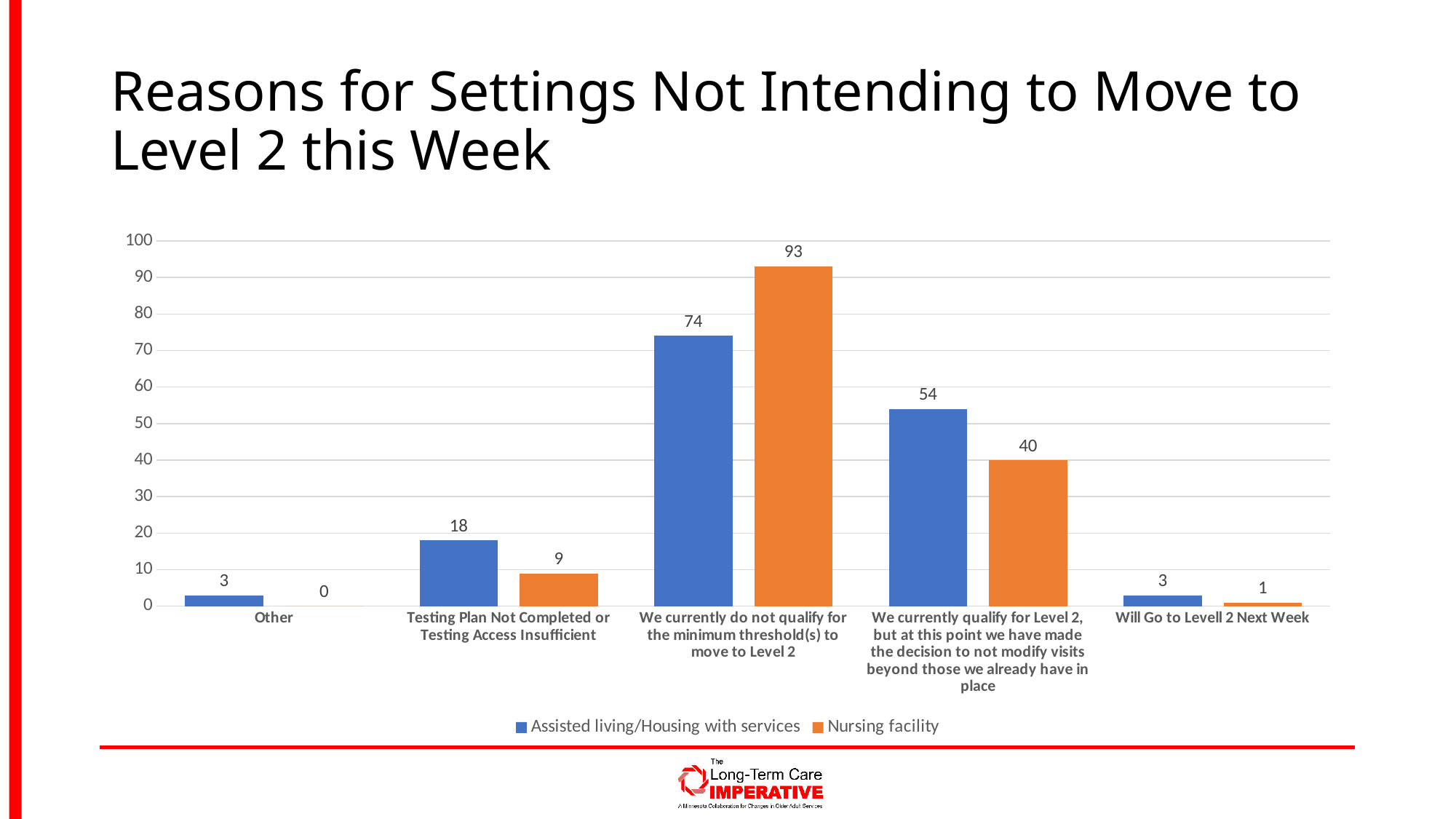
Which category has the lowest value for Nursing facility? Other What colour represents the Nursing facility series? Orange What is the value for Nursing facility in the category 'We currently do not qualify for the minimum threshold(s) to move to Level 2'? 93 What kind of chart is shown on the slide? Bar chart How many series does the legend list? 2 What is the value for Nursing facility in the 'Will Go to Levell 2 Next Week' category? 1 In the 'Testing Plan Not Completed or Testing Access Insufficient' category, which series has the larger value? Assisted living/Housing with services What is the difference between the Assisted living/Housing with services and Nursing facility values in the category 'We currently qualify for Level 2, but at this point we have made the decision to not modify visits beyond those we already have in place'? 14 How many categories are shown on the x axis? 5 What is the value for Nursing facility in the 'Other' category? 0 What is the value for Assisted living/Housing with services in the category 'Testing Plan Not Completed or Testing Access Insufficient'? 18 Which category has the highest value for Assisted living/Housing with services? We currently do not qualify for the minimum threshold(s) to move to Level 2